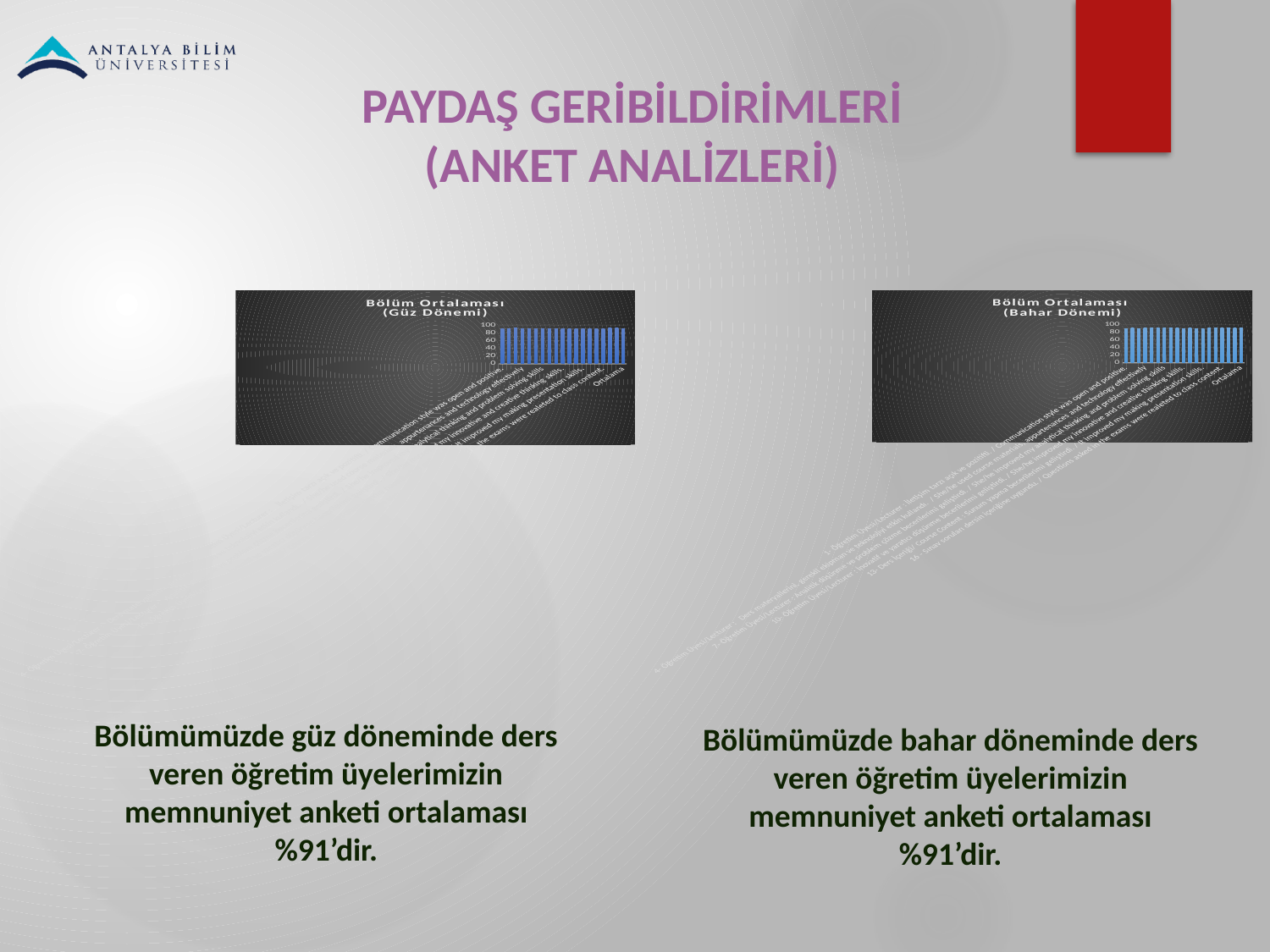
What kind of chart is the chart on the left titled "Bölüm Ortalaması (Güz Dönemi)"? bar chart What is the title of the chart on the left side of the slide? Bölüm Ortalaması (Güz Dönemi) What is the title of the chart on the right side of the slide? Bölüm Ortalaması (Bahar Dönemi) In the chart titled "Bölüm Ortalaması (Bahar Dönemi)", is the value for Ortalama greater or less than 40? greater What kind of chart is the chart on the right titled "Bölüm Ortalaması (Bahar Dönemi)"? bar chart In the chart titled "Bölüm Ortalaması (Güz Dönemi)", is the value for Ortalama greater or less than 40? greater In the chart titled "Bölüm Ortalaması (Bahar Dönemi)", is the value for Ortalama greater or less than 60? greater